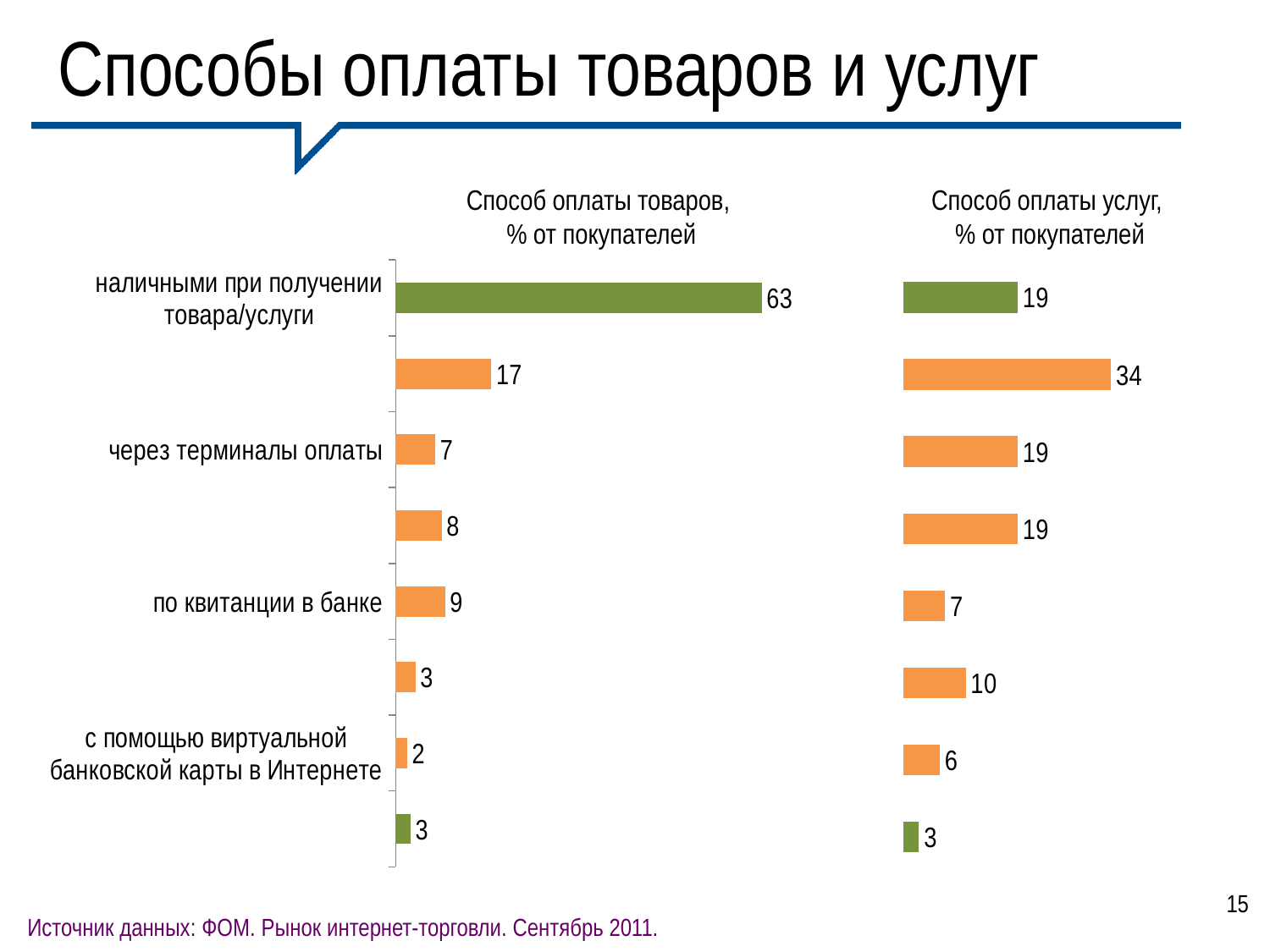
How many bars does the chart 'Способ оплаты товаров, % от покупателей' contain? 8 In the chart 'Способ оплаты услуг, % от покупателей', what is the value for 'наличными при получении товара/услуги'? 19 In the chart 'Способ оплаты услуг, % от покупателей', what is the value for 'с помощью виртуальной банковской карты в Интернете'? 6 In the chart 'Способ оплаты товаров, % от покупателей', what is the value for 'через терминалы оплаты'? 7 What type of chart is 'Способ оплаты услуг, % от покупателей'? bar chart In the chart 'Способ оплаты услуг, % от покупателей', what is the difference between 'через терминалы оплаты' and 'по квитанции в банке'? 12 In the chart 'Способ оплаты товаров, % от покупателей', what is the value for 'наличными при получении товара/услуги'? 63 Which is larger: the value for 'через терминалы оплаты' in the chart 'Способ оплаты товаров' or in the chart 'Способ оплаты услуг'? Способ оплаты услуг In the chart 'Способ оплаты товаров, % от покупателей', which category has the highest value? наличными при получении товара/услуги What is the title of the left chart on the slide? Способ оплаты товаров, % от покупателей In the chart 'Способ оплаты услуг, % от покупателей', what is the value for 'по квитанции в банке'? 7 In the chart 'Способ оплаты товаров, % от покупателей', what is the difference between 'наличными при получении товара/услуги' and 'по квитанции в банке'? 54